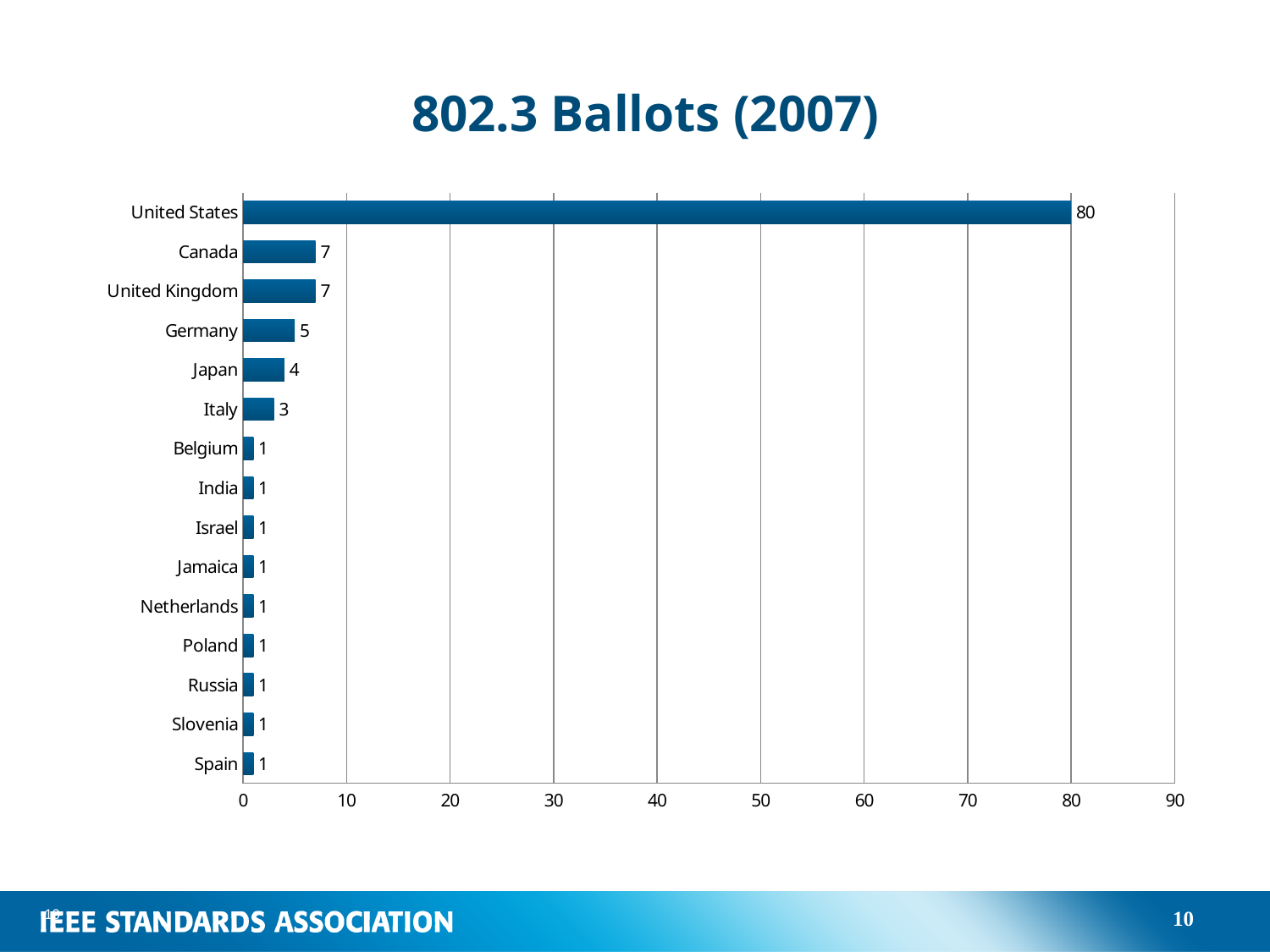
How many countries are shown in the chart? 15 What is the title of the chart? 802.3 Ballots (2007) What is the difference between the values for Germany and Italy? 2 Which country has the highest value? United States What is the value for Germany? 5 What is the difference between the values for the United States and Canada? 73 Is the value for the United States greater or less than 70? greater What kind of chart is shown on the slide? bar chart What is the value for Japan? 4 What is the value for Italy? 3 What is the value for the United States? 80 Which is larger, the value for Japan or the value for Italy? Japan